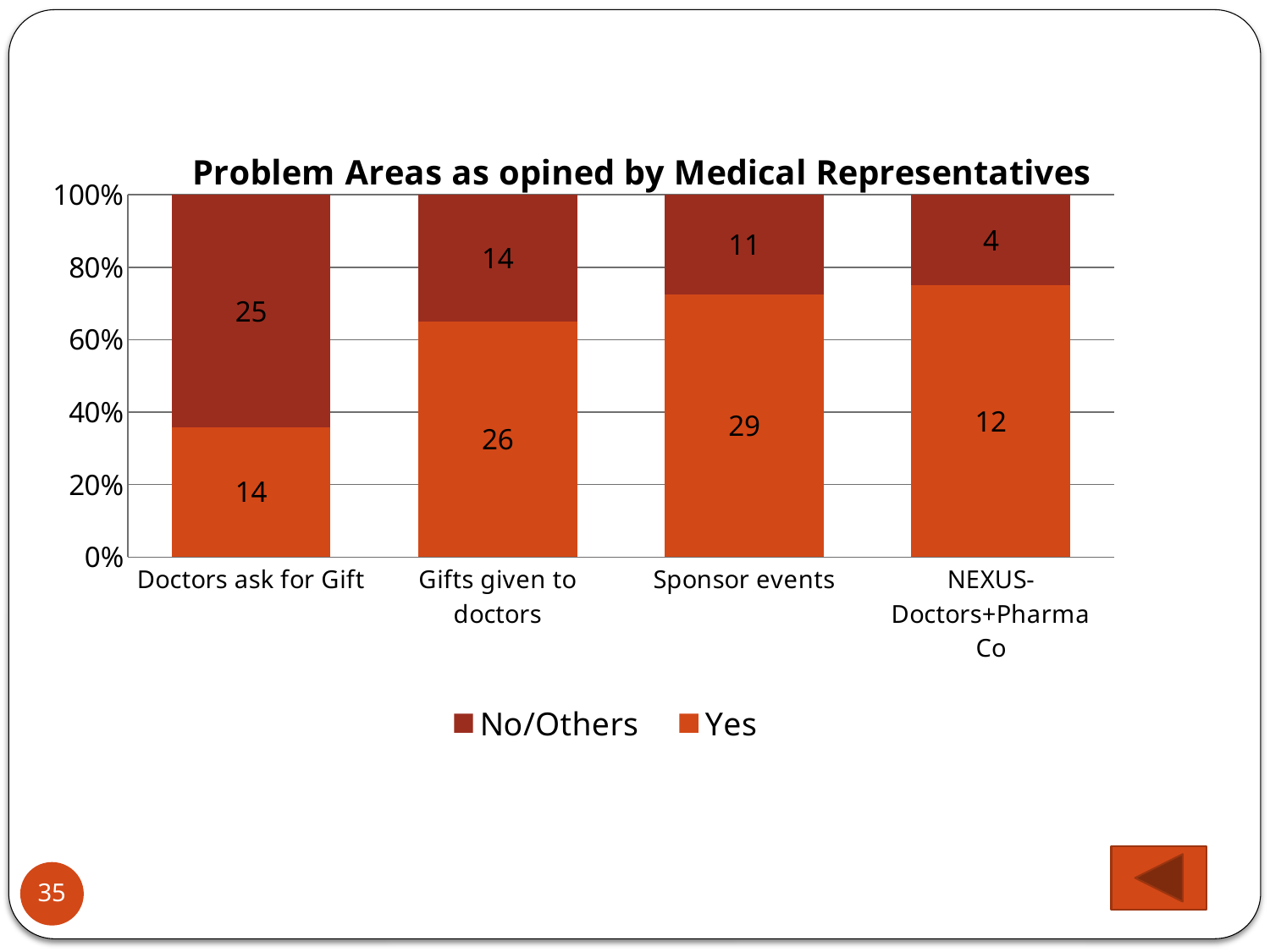
Which is larger for Gifts given to doctors: the 'Yes' value or the 'No/Others' value? Yes What is the 'Yes' value for Sponsor events? 29 What is the 'Yes' value for NEXUS-Doctors+Pharma Co? 12 How many series does the legend list? 2 What is the difference between the 'Yes' and 'No/Others' values for Doctors ask for Gift? 11 What is the 'No/Others' value for Doctors ask for Gift? 25 What is the title of the chart? Problem Areas as opined by Medical Representatives How many categories are shown on the x axis? 4 What kind of chart is shown? Stacked bar chart Which category has the lowest 'No/Others' value? NEXUS-Doctors+Pharma Co Is the 'Yes' share of the bar for Doctors ask for Gift greater or less than 40%? less Which category has the highest 'Yes' value? Sponsor events